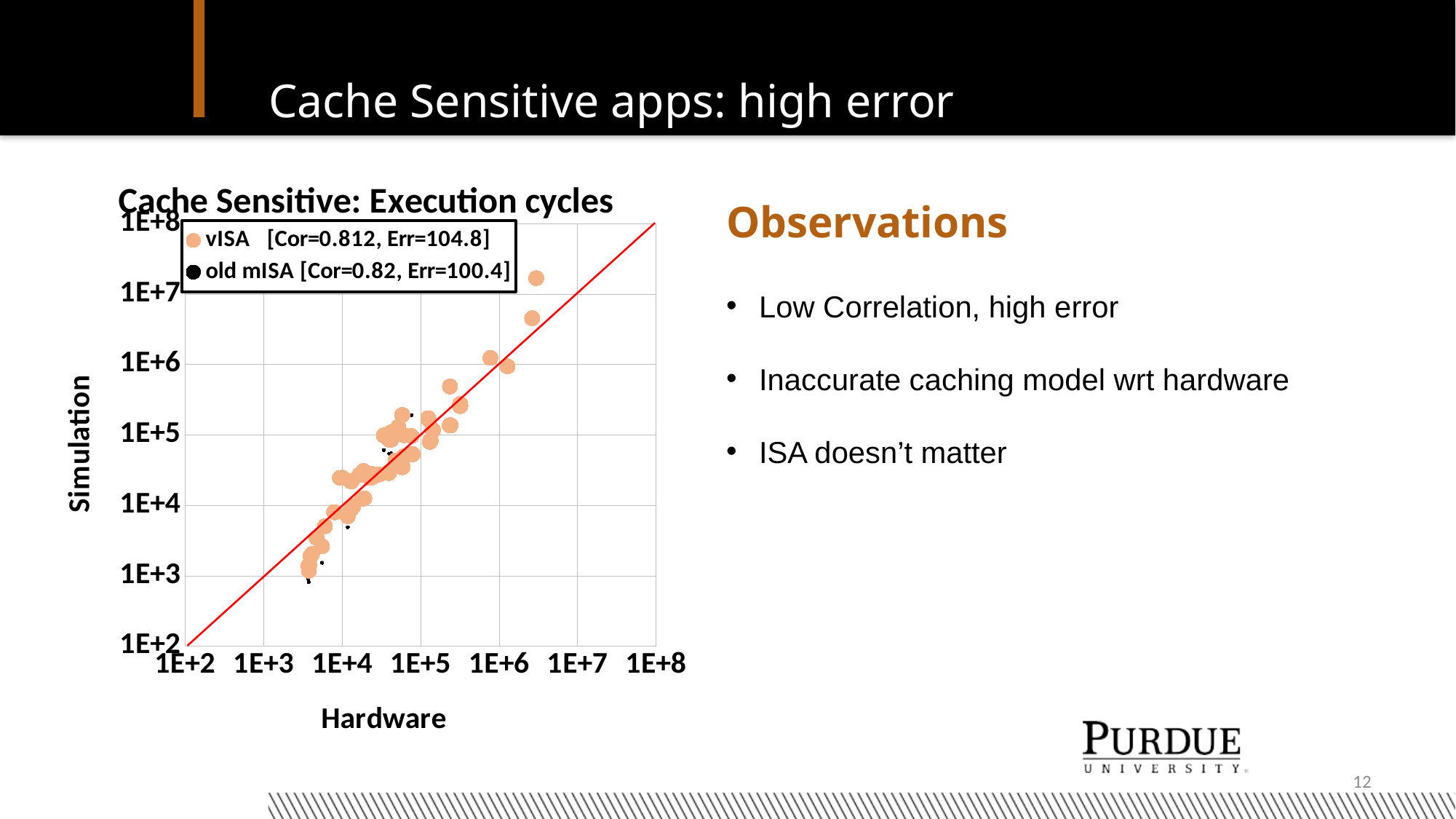
Is the Simulation value of the lowest vISA point greater or less than 1E+4? less What is the label of the x axis of the chart? Hardware Do the Simulation values generally rise or fall as the Hardware values increase along the x axis? rise How many series does the legend of the chart list? 2 What error value is given for the old mISA series in the legend? 100.4 What kind of chart is shown on the slide? scatter chart What correlation value is given for the vISA series in the legend? 0.812 What is the highest tick value shown on the y axis (Simulation)? 1E+8 Which series has the higher error value according to the legend, vISA or old mISA? vISA What is the title of the chart? Cache Sensitive: Execution cycles Is the Simulation value of the topmost vISA point greater or less than 1E+7? greater Which series has the higher correlation value according to the legend, vISA or old mISA? old mISA